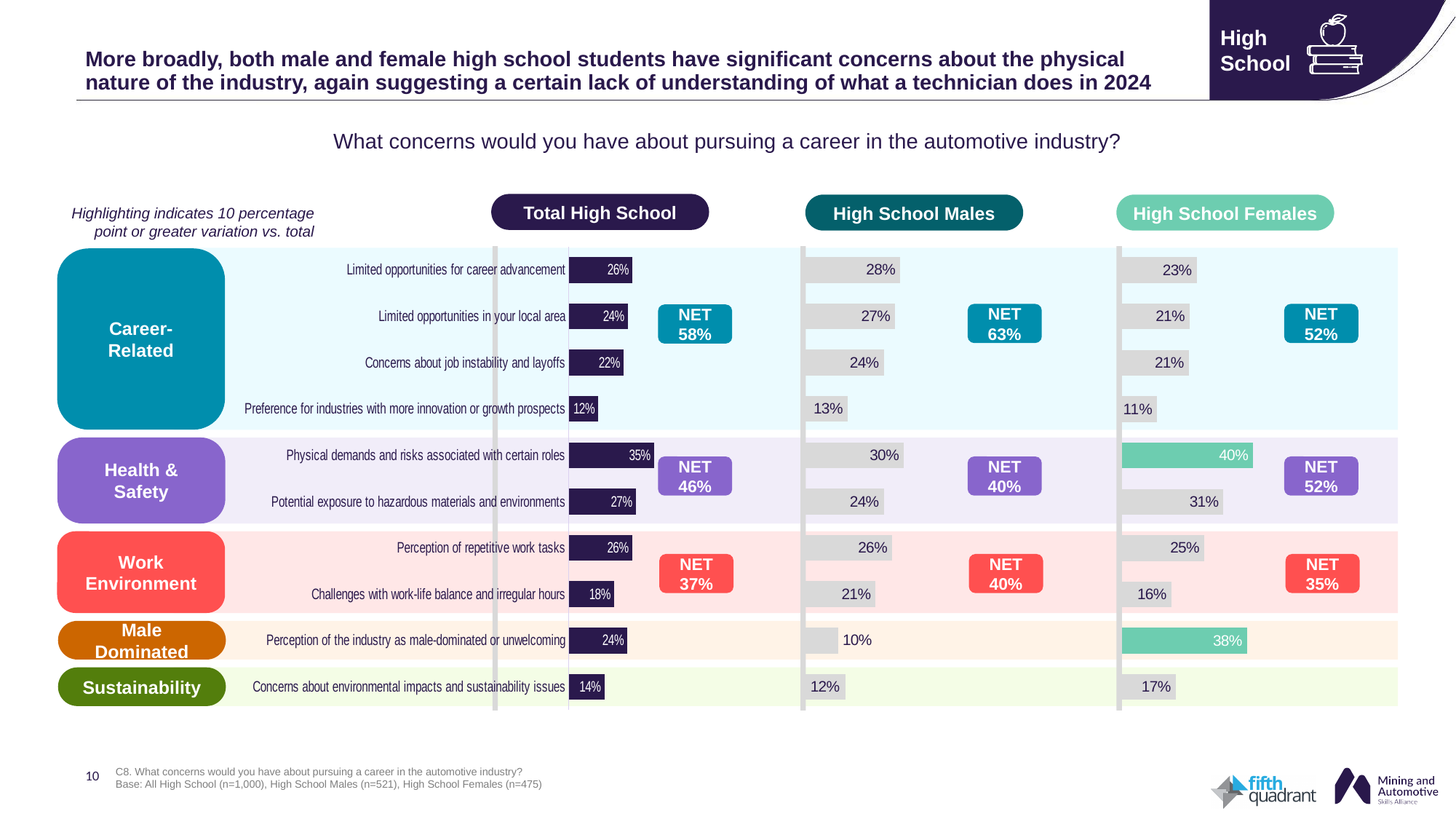
What type of chart is used to show the concerns for each group? Bar chart How many individual concern items are plotted in the Total High School chart? 10 What is the NET value for Health & Safety concerns in the Total High School chart? 46% Which is larger: the Total High School value for potential exposure to hazardous materials and environments, or the High School Females value for the same concern? High School Females In the High School Females chart, what is the value for perception of the industry as male-dominated or unwelcoming? 38% What is the NET value for Career-Related concerns in the High School Males chart? 63% What does the highlighting of a bar indicate, according to the note on the slide? 10 percentage point or greater variation vs. total In the High School Males chart, which concern has the lowest percentage? Perception of the industry as male-dominated or unwelcoming In the High School Females chart, which concern has the highest percentage? Physical demands and risks associated with certain roles In the Total High School chart, what percentage of students cited physical demands and risks associated with certain roles as a concern? 35% What is the difference between the High School Females and High School Males values for perception of the industry as male-dominated or unwelcoming? 28 percentage points In the High School Males chart, what is the value for limited opportunities for career advancement? 28%